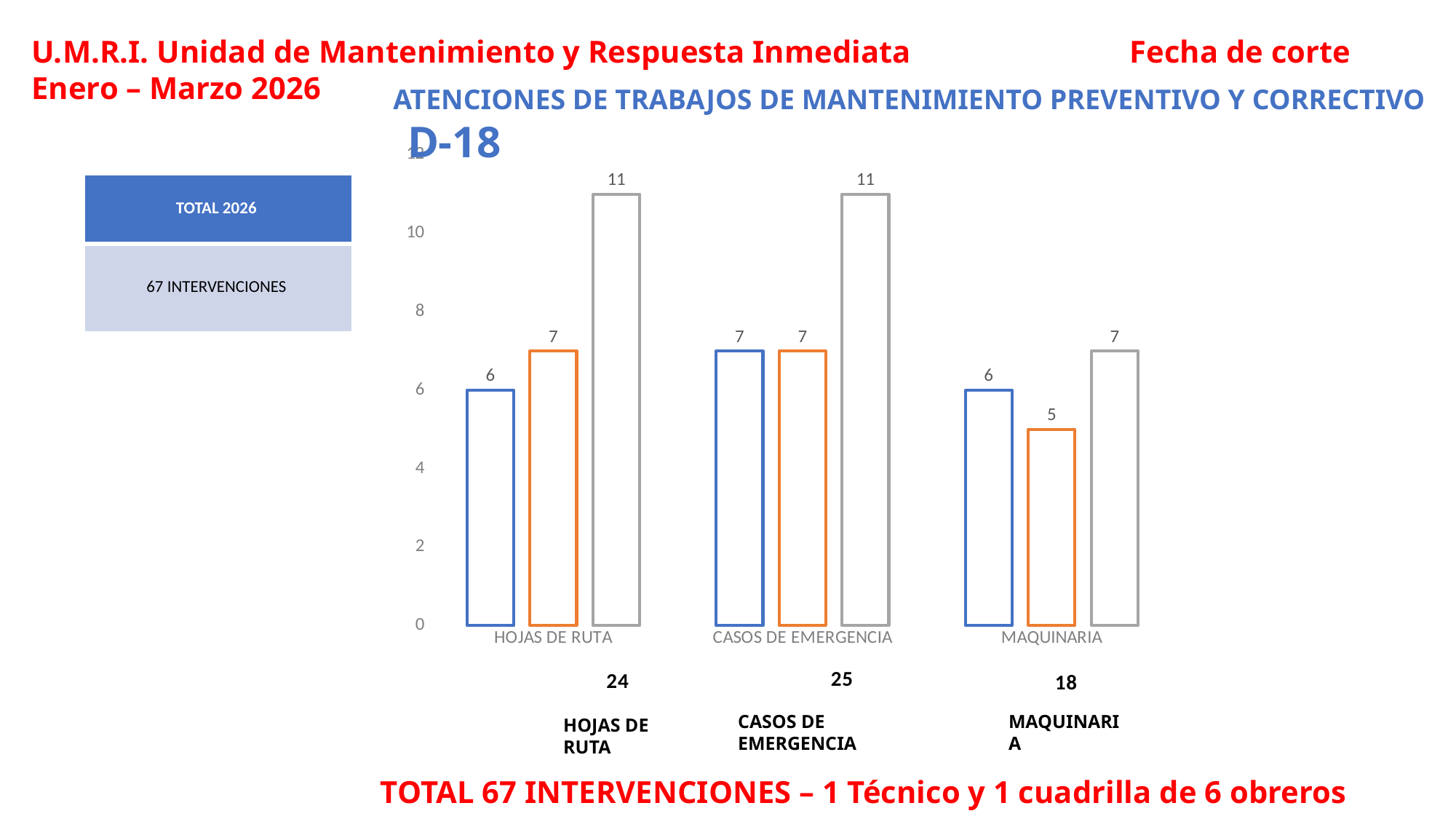
Which is larger: the orange bar for HOJAS DE RUTA or the orange bar for MAQUINARIA? HOJAS DE RUTA How many categories are shown on the x axis of the chart? 3 Which category has the lowest gray bar? MAQUINARIA What is the value of the orange bar for CASOS DE EMERGENCIA? 7 What is the value of the gray bar for HOJAS DE RUTA? 11 What type of chart is shown on the slide? bar chart What is the value of the blue bar for MAQUINARIA? 6 What is the value of the orange bar for MAQUINARIA? 5 What is the difference between the gray bar and the blue bar for HOJAS DE RUTA? 5 What is the difference between the gray bar for CASOS DE EMERGENCIA and the gray bar for MAQUINARIA? 4 Which category has the highest blue bar? CASOS DE EMERGENCIA What is the title of the chart? ATENCIONES DE TRABAJOS DE MANTENIMIENTO PREVENTIVO Y CORRECTIVO D-18